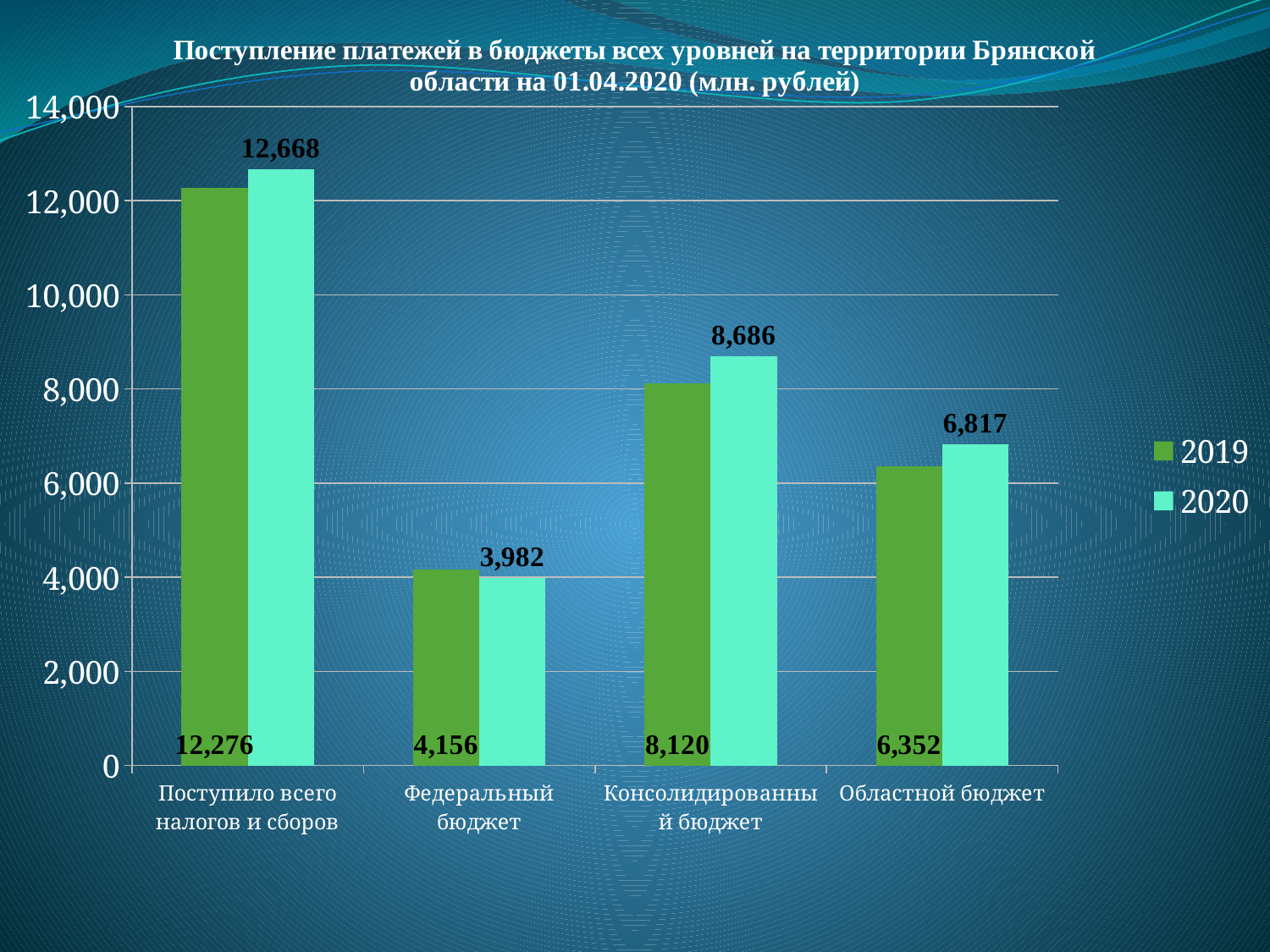
What is the 2020 value for Поступило всего налогов и сборов? 12,668 What is the difference between the 2020 and 2019 values for Консолидированный бюджет? 566 How many categories are shown on the x axis? 4 How many series does the legend list? 2 What is the difference between the 2019 and 2020 values for Федеральный бюджет? 174 What is the 2019 value for Областной бюджет? 6,352 What is the 2019 value for Федеральный бюджет? 4,156 What is the 2020 value for Консолидированный бюджет? 8,686 Which is larger for Областной бюджет, the 2019 value or the 2020 value? 2020 What kind of chart is shown on the slide? Bar chart Which category has the highest 2019 value? Поступило всего налогов и сборов Which category has the lowest 2020 value? Федеральный бюджет